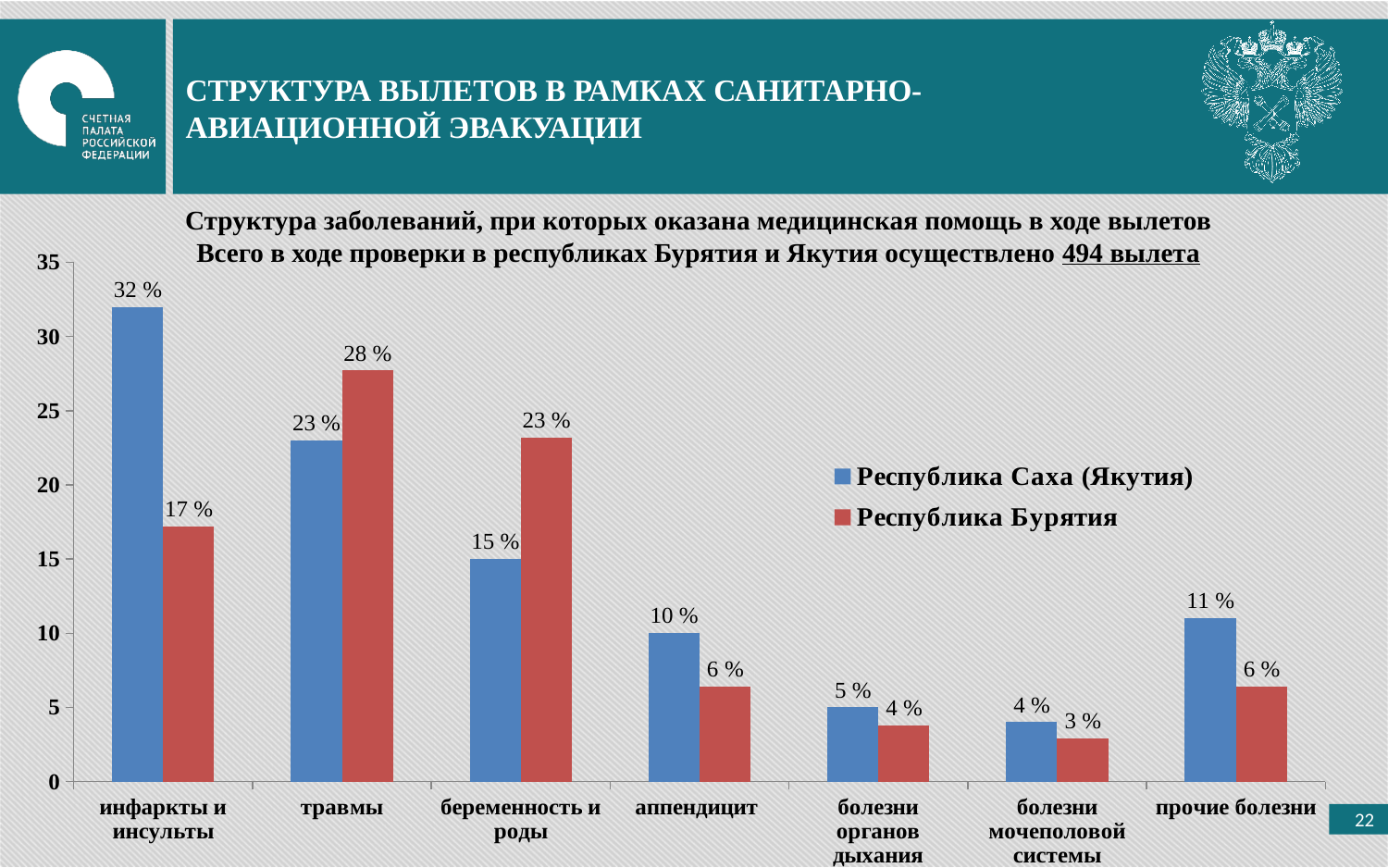
What is the value for Республика Бурятия in the category беременность и роды? 23 % Which category has the lowest value for Республика Бурятия? болезни мочеполовой системы What is the value for Республика Саха (Якутия) in the category инфаркты и инсульты? 32 % What is the value for Республика Саха (Якутия) in the category прочие болезни? 11 % For the category травмы, which series has the larger value: Республика Саха (Якутия) or Республика Бурятия? Республика Бурятия What is the difference between the Республика Саха (Якутия) and Республика Бурятия values for инфаркты и инсульты? 15 % What is the value for Республика Бурятия in the category травмы? 28 % Which category has the highest value for Республика Саха (Якутия)? инфаркты и инсульты What kind of chart is shown on the slide? bar chart Which colour represents Республика Бурятия in the chart? red How many series does the legend list? 2 How many categories are shown on the x axis? 7